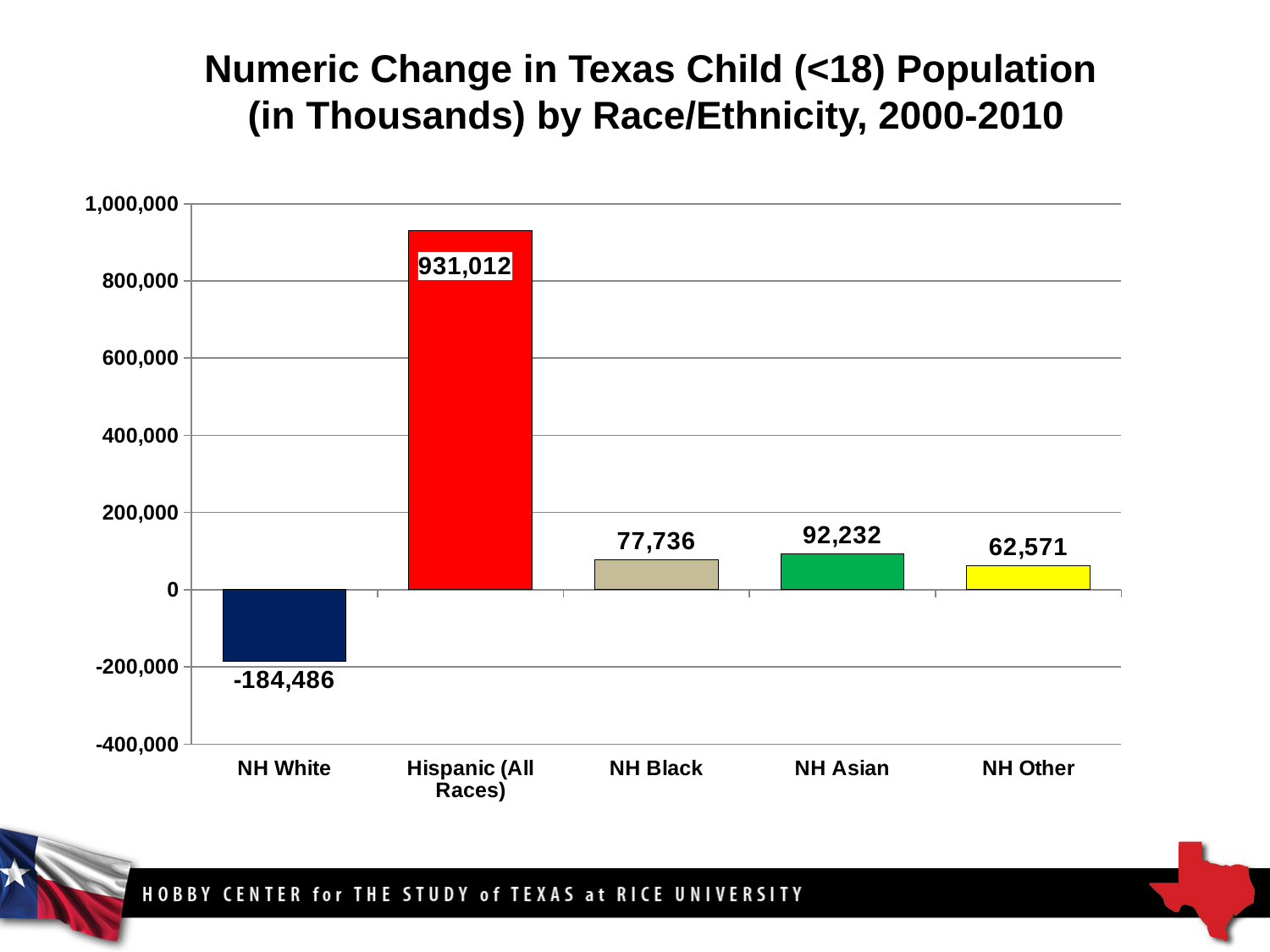
What is the numeric change for NH Asian? 92,232 What is the difference between the numeric change for NH Asian and NH Black? 14,496 Which race/ethnicity group has the lowest numeric change? NH White Which is larger, the numeric change for NH Black or NH Other? NH Black What kind of chart is shown on the slide? bar chart What is the numeric change for NH Other? 62,571 Which race/ethnicity group has the highest numeric change? Hispanic (All Races) What is the numeric change for NH White? -184,486 What is the numeric change for Hispanic (All Races)? 931,012 What colour is the bar for Hispanic (All Races)? red Is the value for Hispanic (All Races) greater or less than 800,000? greater How many race/ethnicity categories are shown on the chart? 5